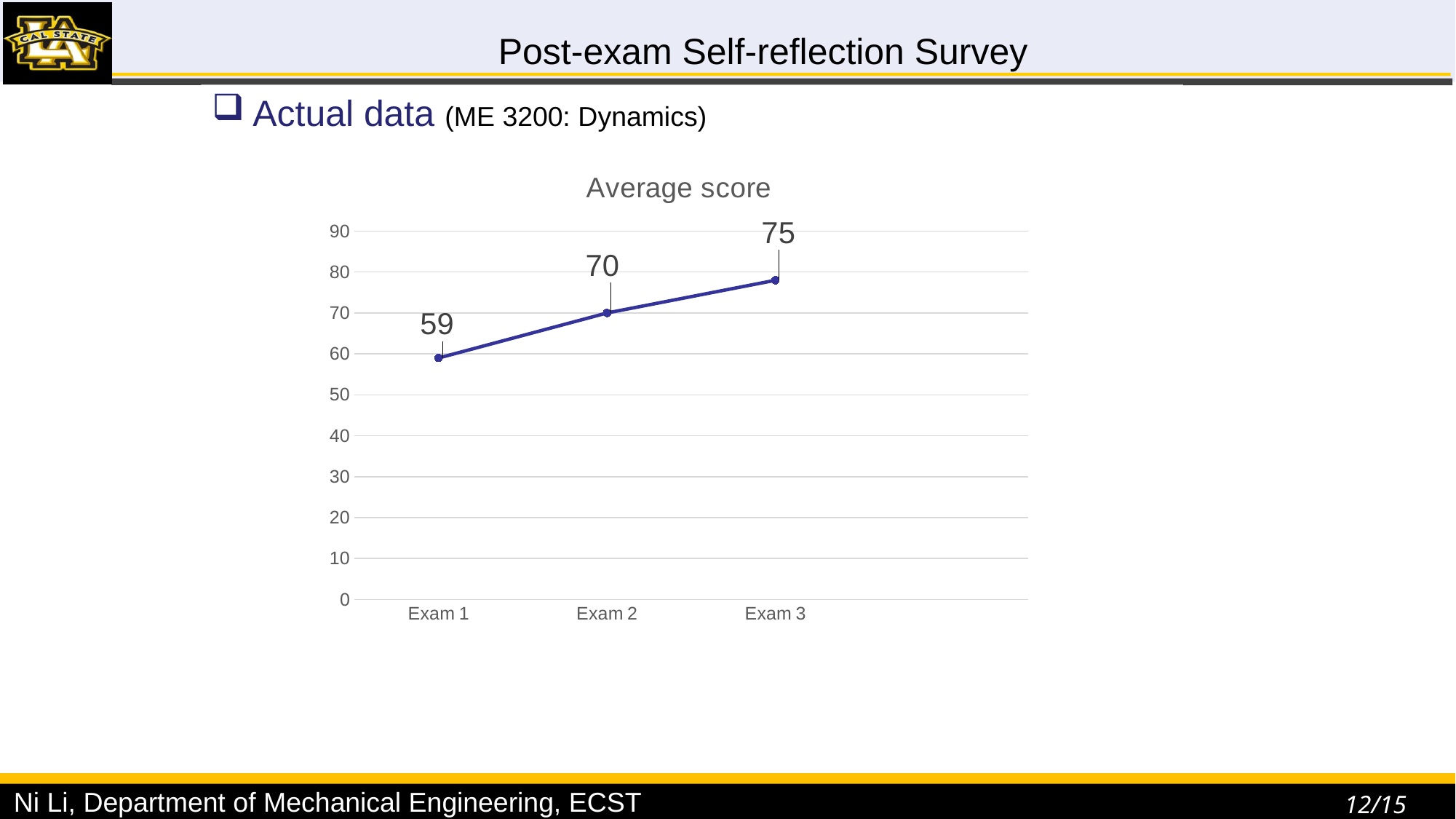
What is the average score for Exam 2? 70 What is the average score for Exam 3? 75 Which has a higher average score, Exam 2 or Exam 3? Exam 3 Is the average score for Exam 1 greater or less than 60? less Which exam has the lowest average score? Exam 1 What kind of chart is shown on the slide? line chart How many exams are plotted on the chart? 3 Do the average scores rise or fall from Exam 1 to Exam 3? rise What is the difference between the average scores for Exam 3 and Exam 1? 16 What is the average score for Exam 1? 59 Which exam has the highest average score? Exam 3 What is the difference between the average scores for Exam 2 and Exam 1? 11